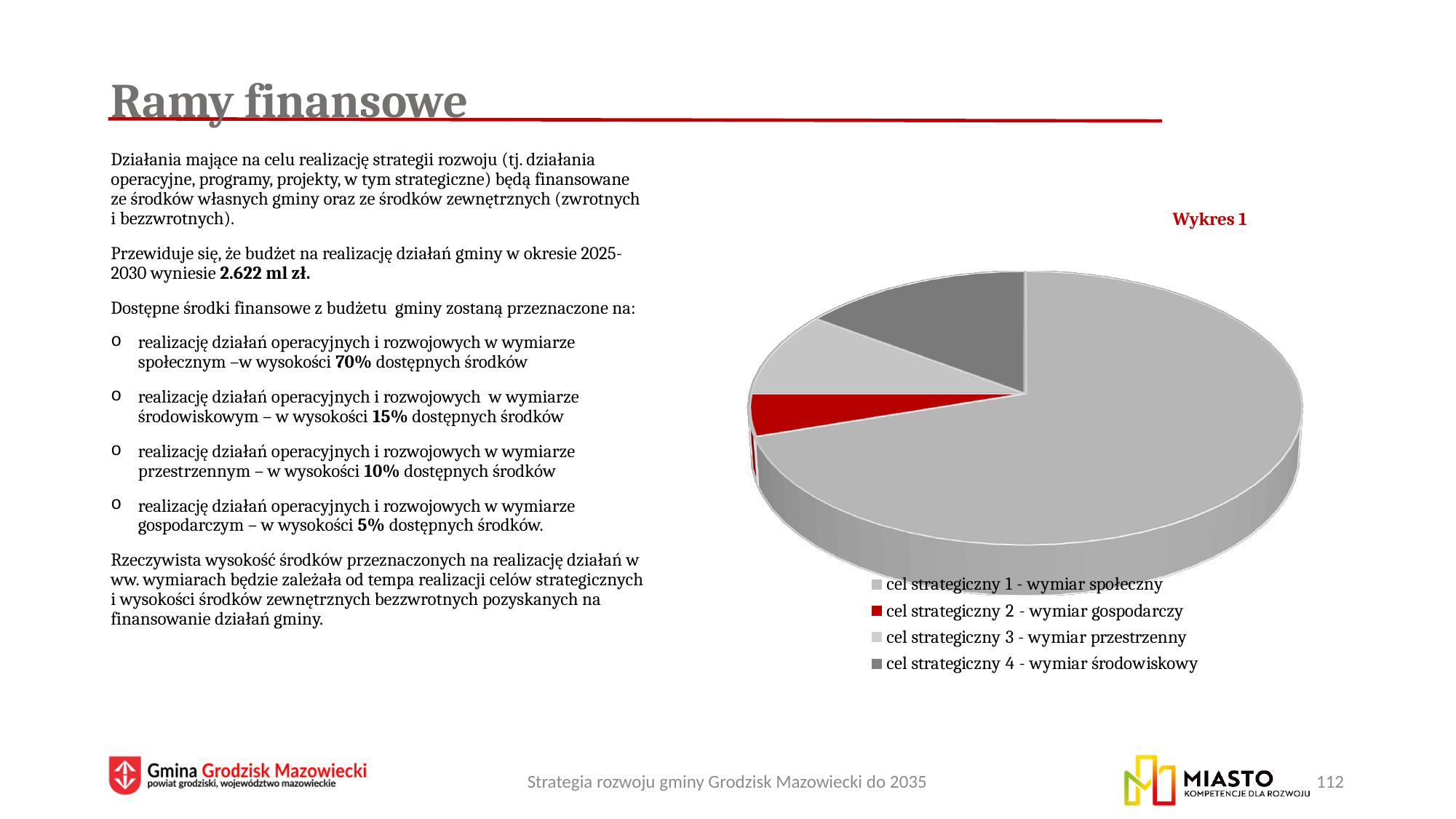
What colour is the slice for cel strategiczny 2 - wymiar gospodarczy in Wykres 1? red In Wykres 1, which slice is larger: cel strategiczny 3 - wymiar przestrzenny or cel strategiczny 2 - wymiar gospodarczy? cel strategiczny 3 - wymiar przestrzenny In Wykres 1, which slice is larger: cel strategiczny 1 - wymiar społeczny or cel strategiczny 4 - wymiar środowiskowy? cel strategiczny 1 - wymiar społeczny What is the title of the pie chart on the slide? Wykres 1 According to the slide, what share of available funds goes to the wymiar gospodarczy slice of Wykres 1? 5% According to the slide, what share of available funds goes to the wymiar społeczny slice of Wykres 1? 70% In Wykres 1, which slice is larger: cel strategiczny 4 - wymiar środowiskowy or cel strategiczny 3 - wymiar przestrzenny? cel strategiczny 4 - wymiar środowiskowy What kind of chart is Wykres 1? pie chart Which category has the smallest slice in Wykres 1? cel strategiczny 2 - wymiar gospodarczy Which category has the largest slice in Wykres 1? cel strategiczny 1 - wymiar społeczny How many slices does the pie chart Wykres 1 have? 4 According to the slide, what share of available funds goes to the wymiar środowiskowy slice of Wykres 1? 15%